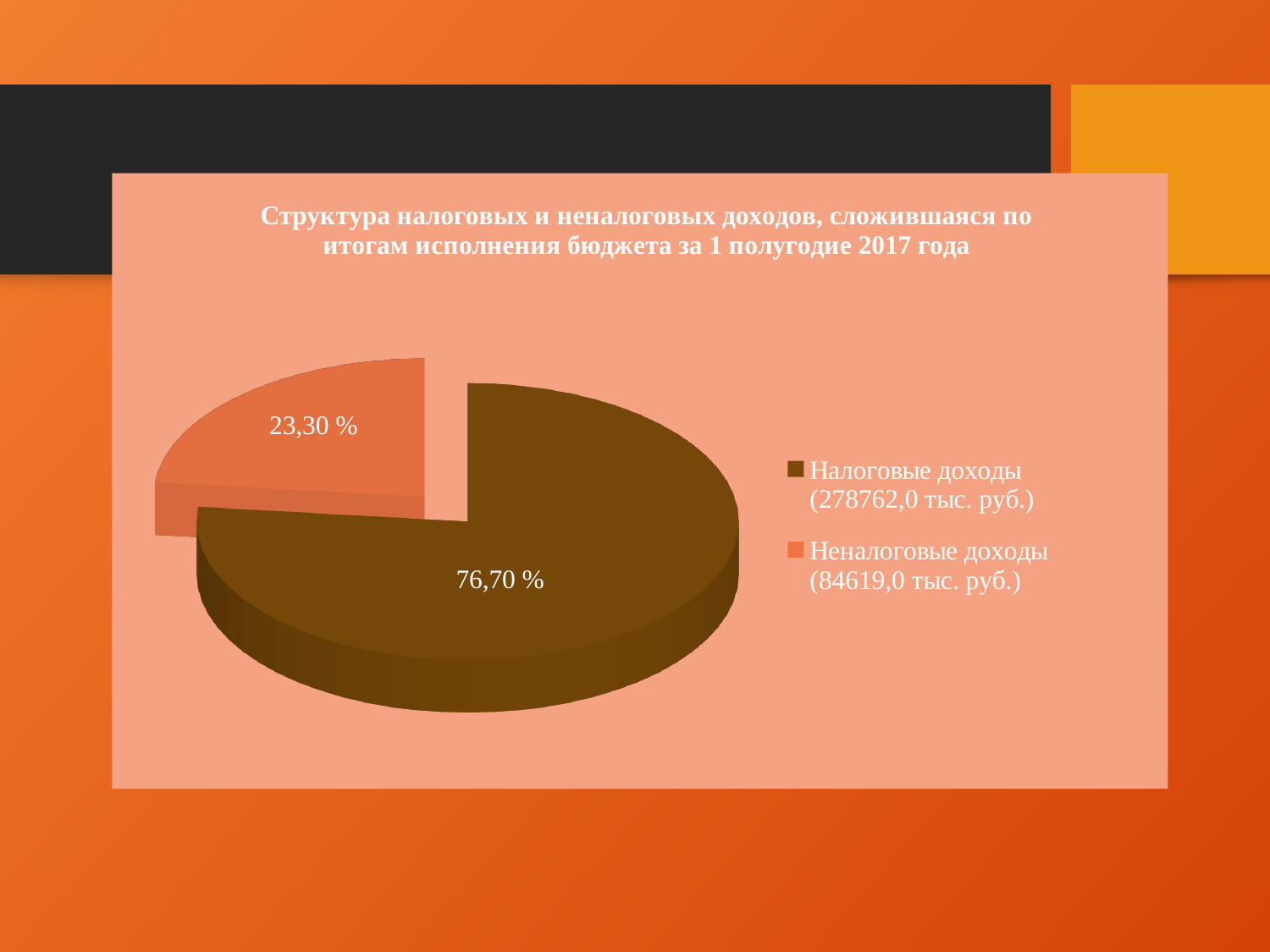
Which category has the smallest slice of the pie? Неналоговые доходы (84619,0 тыс. руб.) What is the title of the chart? Структура налоговых и неналоговых доходов, сложившаяся по итогам исполнения бюджета за 1 полугодие 2017 года What amount in тыс. руб. is given in the legend for Неналоговые доходы? 84619,0 тыс. руб. How many slices does the pie chart have? 2 What amount in тыс. руб. is given in the legend for Налоговые доходы? 278762,0 тыс. руб. Which category has the largest slice of the pie? Налоговые доходы (278762,0 тыс. руб.) What share of the pie does Неналоговые доходы (84619,0 тыс. руб.) represent? 23,30 % What is the difference in percentage points between the Налоговые доходы slice and the Неналоговые доходы slice? 53,40 % What share of the pie does Налоговые доходы (278762,0 тыс. руб.) represent? 76,70 % What kind of chart is shown on the slide? Pie chart Which slice is larger: Налоговые доходы or Неналоговые доходы? Налоговые доходы How many entries does the legend list? 2